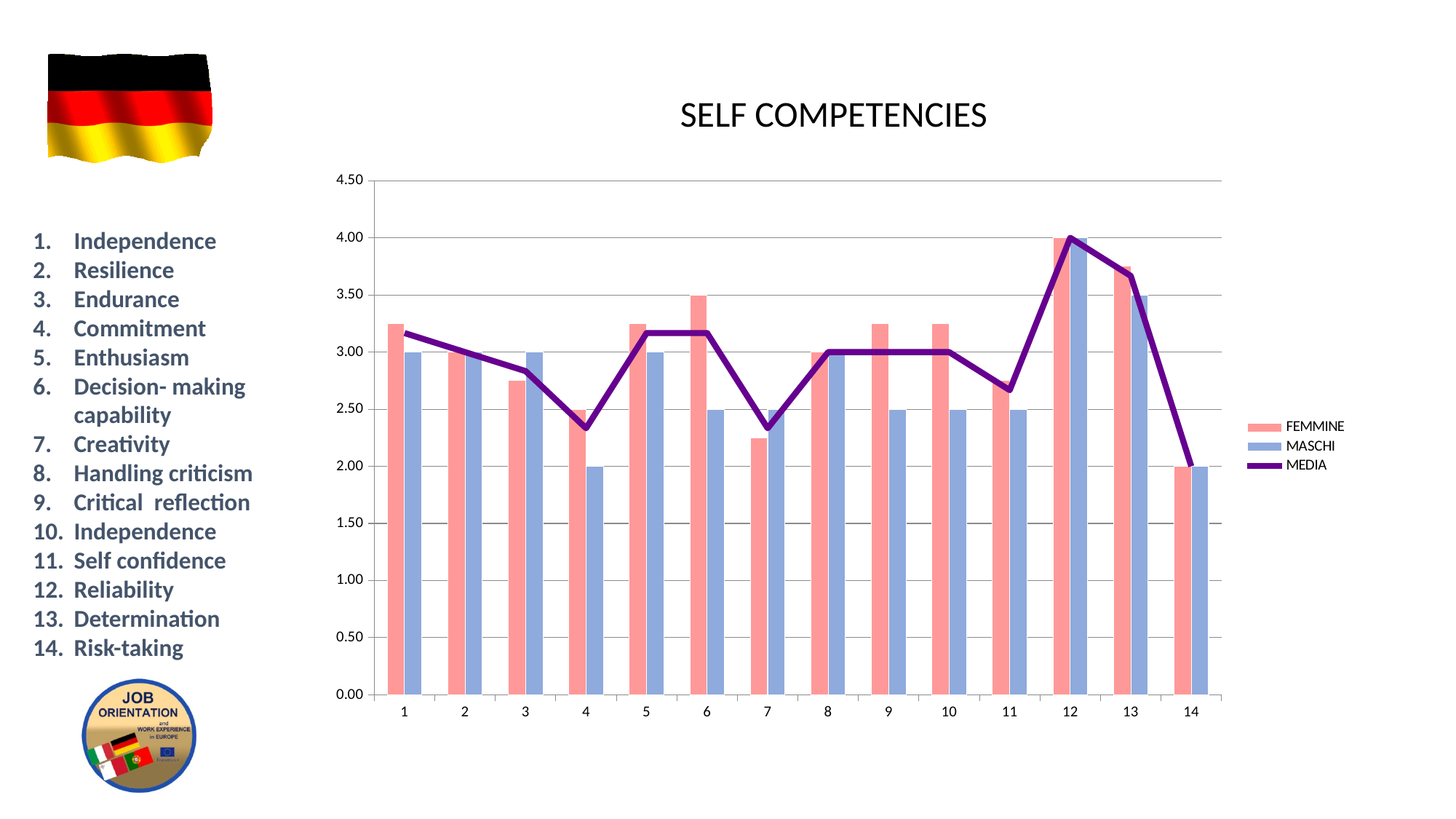
Which category has the highest FEMMINE value? 12 How many categories are shown on the x axis? 14 What is the MASCHI value for category 13? 3.50 What is the title of the chart? SELF COMPETENCIES Does the MEDIA line rise or fall from category 12 to category 14? fall What is the difference between the FEMMINE and MASCHI values for category 6? 1.00 For category 6, which is larger, FEMMINE or MASCHI? FEMMINE Which category has the lowest FEMMINE value? 14 What is the FEMMINE value for category 6? 3.50 What is the MASCHI value for category 12? 4.00 How many series does the legend list? 3 Is the FEMMINE value for category 13 greater or less than 3.50? greater